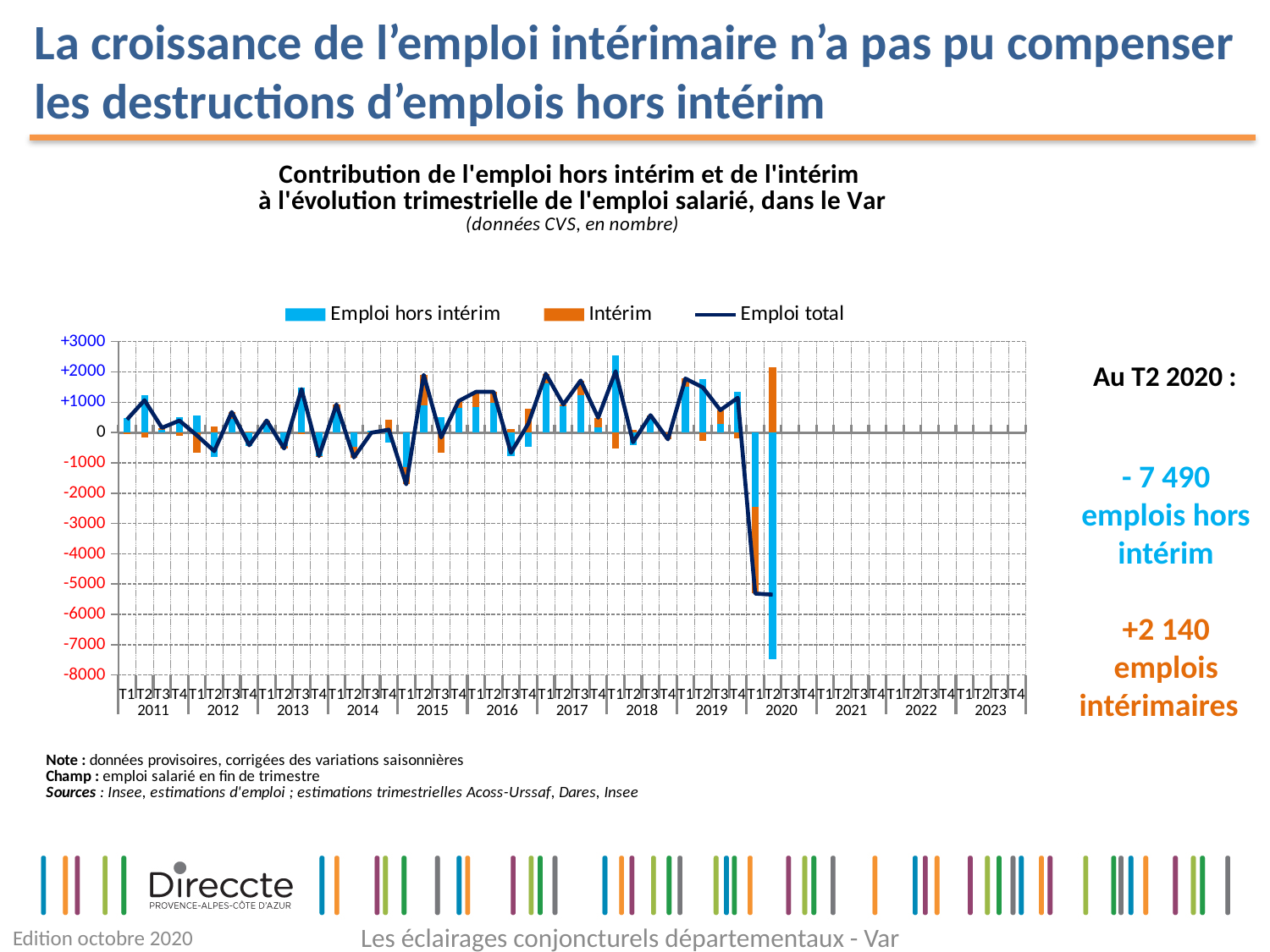
Is the value for Emploi total at T2 2020 greater or less than -4000? less How many series does the legend list? 3 What kind of chart is shown on the slide? bar chart with a line What is the value for Emploi hors intérim at T2 2020? - 7 490 Is the value for Intérim at T2 2020 greater or less than +2000? greater What colour are the Intérim bars? orange At T2 2020, which is larger: Emploi hors intérim or Intérim? Intérim How many years are labelled on the x axis? 13 Is the value for Emploi hors intérim at T2 2018 greater or less than +2000? less Which quarter has the highest value for Intérim? T2 2020 What is the value for Intérim at T2 2020? +2 140 Which quarter has the lowest value for Emploi hors intérim? T2 2020